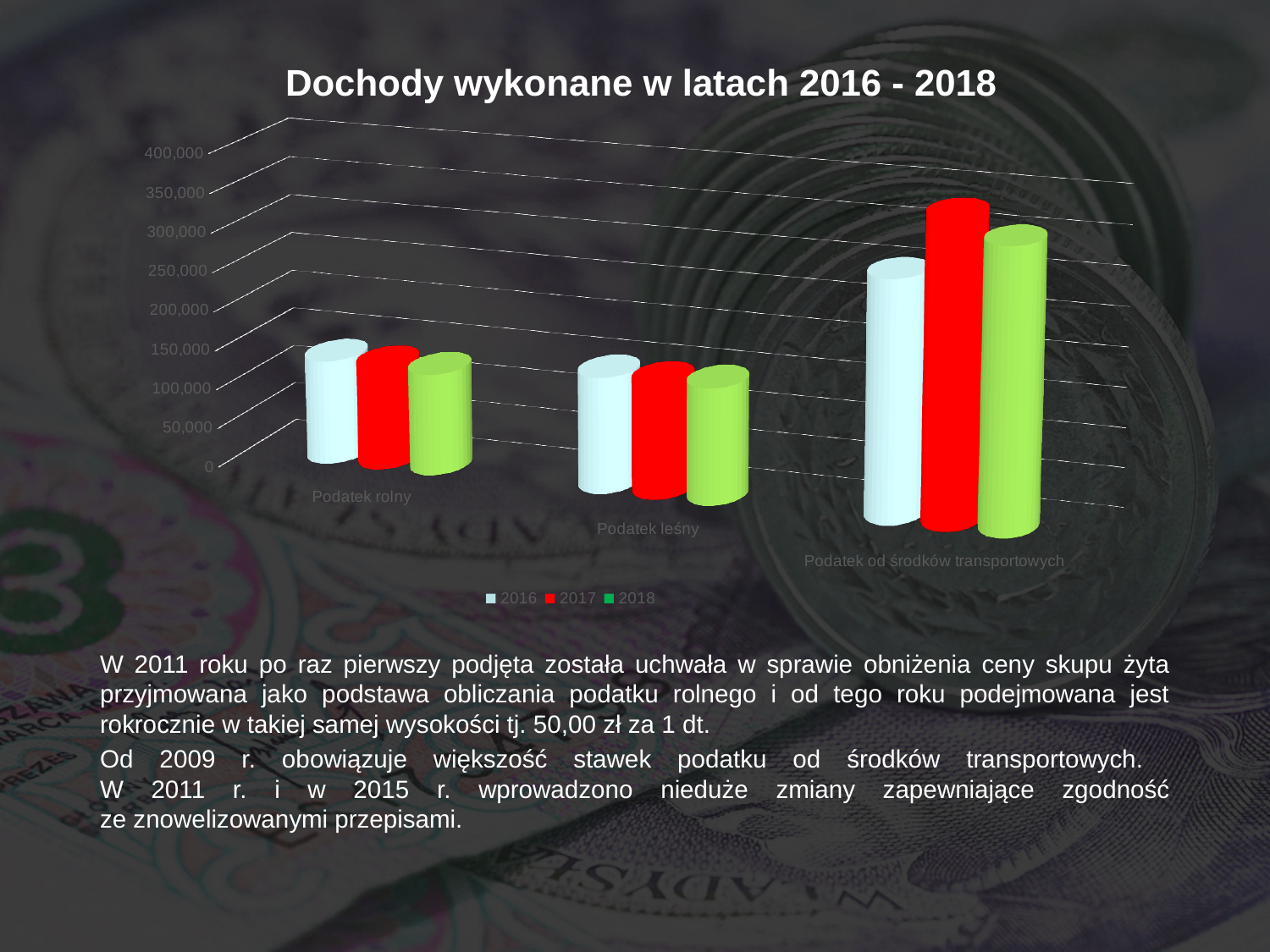
What kind of chart is shown on the slide? bar chart Which series are listed in the chart's legend? 2016, 2017, 2018 How many categories are shown on the x axis of the chart? 3 Is the value for 2016 in Podatek rolny greater or less than 200,000? less Which category has the highest values in the chart? Podatek od środków transportowych What is the title of the chart? Dochody wykonane w latach 2016 - 2018 For Podatek od środków transportowych, is the value for 2017 larger or smaller than the value for 2016? larger For Podatek od środków transportowych, which year has the tallest bar? 2017 Is the value for 2018 in Podatek od środków transportowych greater or less than 150,000? greater Is the value for 2018 in Podatek leśny greater or less than 250,000? less How many series does the chart's legend list? 3